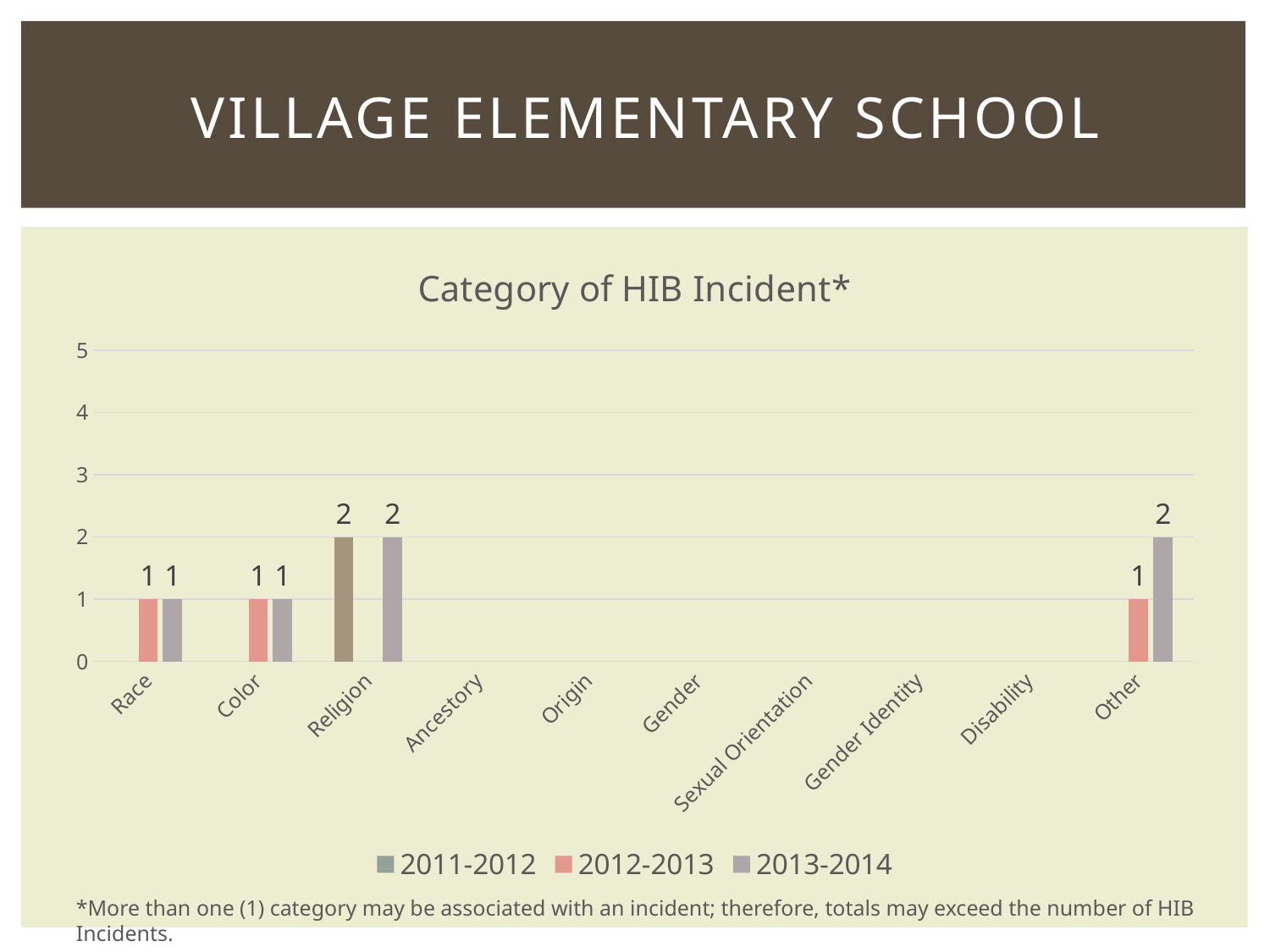
For Other, which series has the larger value, 2012-2013 or 2013-2014? 2013-2014 What kind of chart is shown on the slide? Bar chart How many categories are shown on the x axis? 10 How many series does the legend list? 3 What is the 2013-2014 value for Other? 2 What is the 2012-2013 value for Race? 1 What is the 2013-2014 value for Religion? 2 What is the 2013-2014 value for Color? 1 For Other, what is the difference between the 2013-2014 value and the 2012-2013 value? 1 What is the title of the chart? Category of HIB Incident* Which series are listed in the legend? 2011-2012, 2012-2013, 2013-2014 What is the 2012-2013 value for Other? 1